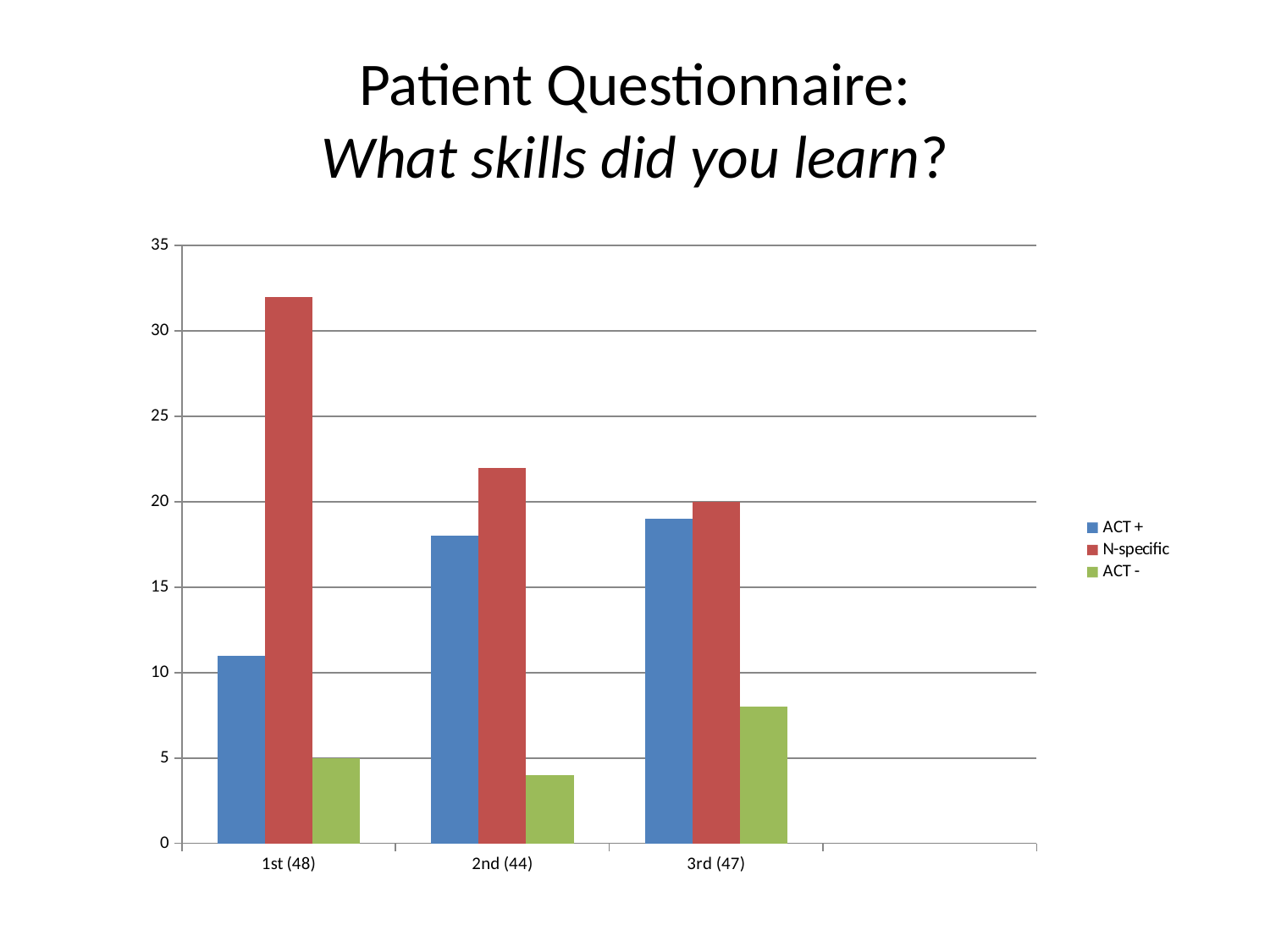
Which series has the lowest value for 2nd (44)? ACT - Which series is shown in red in the legend? N-specific How many categories are shown on the x axis? 3 Is the value for ACT + at 2nd (44) greater or less than 15? greater How many series does the legend list? 3 Which series has the highest value for 1st (48)? N-specific Is the value for N-specific at 1st (48) greater or less than 30? greater Is the value for ACT - at 3rd (47) greater or less than 10? less Which is larger, the N-specific value for 1st (48) or the N-specific value for 2nd (44)? 1st (48) What kind of chart is shown on the slide? bar chart Do the N-specific values rise or fall from 1st (48) to 3rd (47)? fall